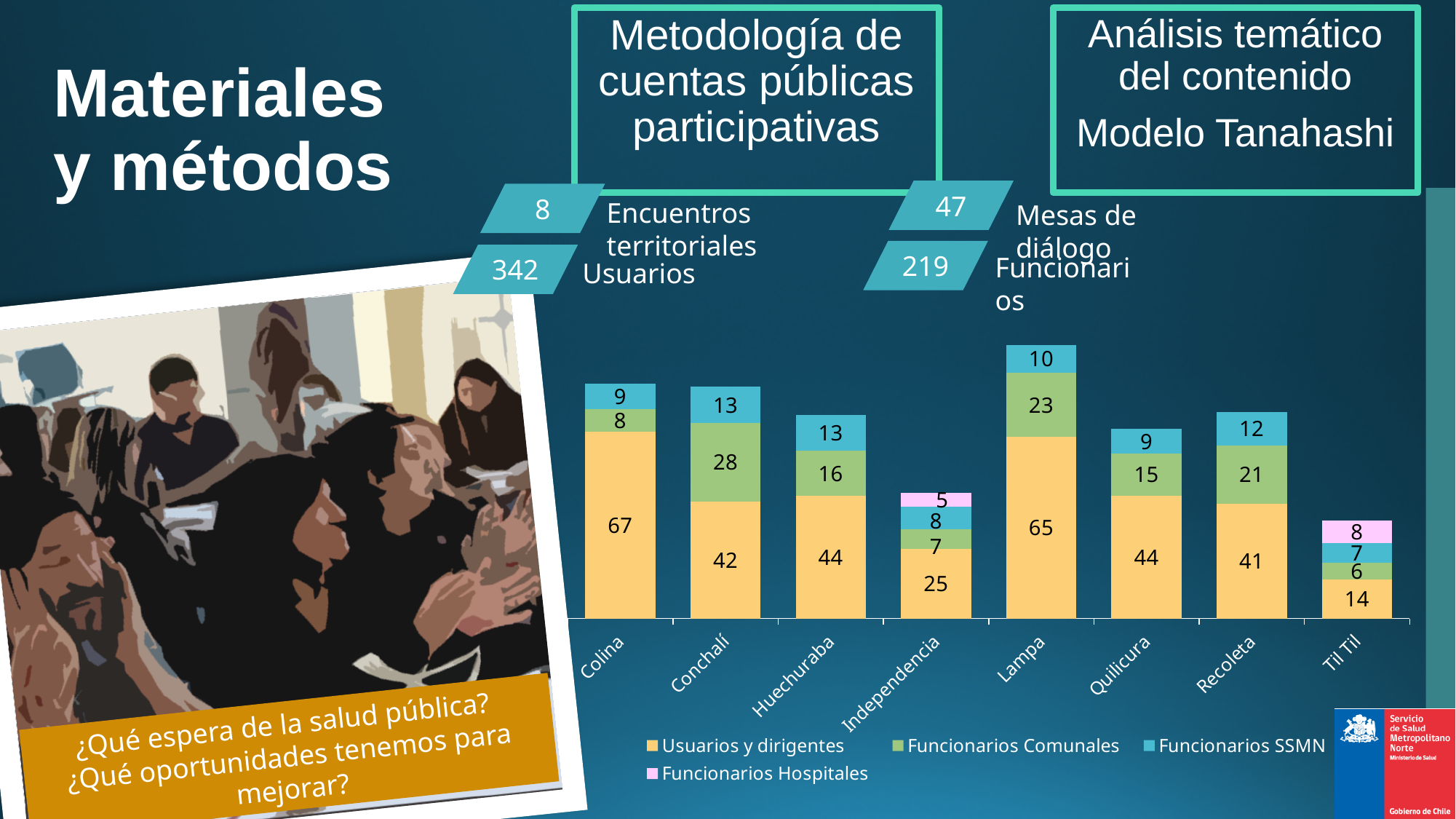
What is the difference between the Usuarios y dirigentes values for Colina and Conchalí? 25 What is the value for Usuarios y dirigentes in Colina? 67 What is the value for Funcionarios Comunales in Conchalí? 28 Which comuna has the lowest value for Usuarios y dirigentes? Til Til Which comuna has the highest value for Usuarios y dirigentes? Colina What is the total of the stacked bar for Lampa? 98 What is the total of the stacked bar for Independencia? 45 How many series does the chart legend list? 4 What type of chart is shown on the slide? stacked bar chart What is the value for Funcionarios Hospitales in Til Til? 8 How many categories (comunas) are shown on the x axis of the chart? 8 Which is larger: the Funcionarios Comunales value for Lampa or for Recoleta? Lampa